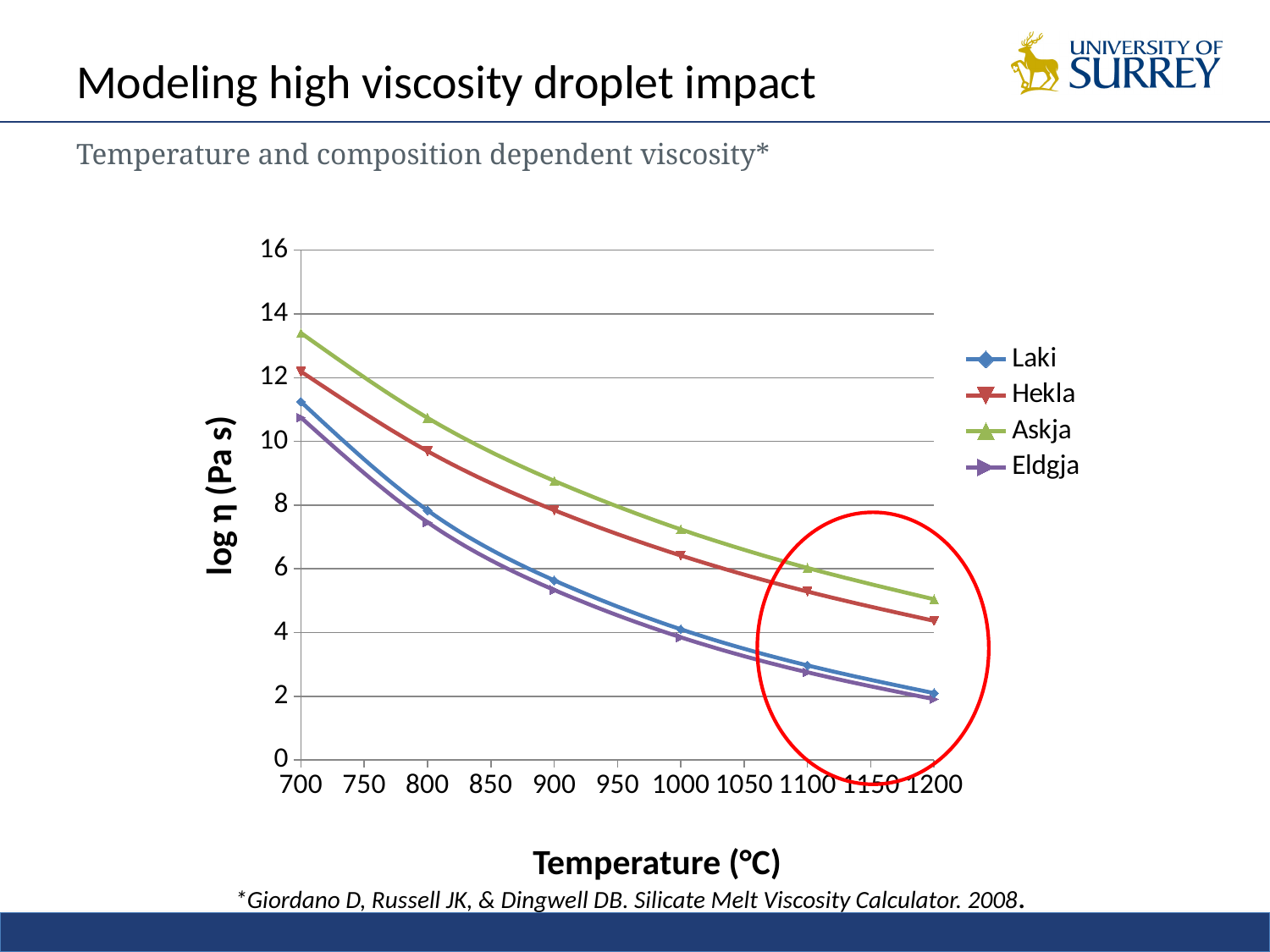
Do the log η values rise or fall as temperature increases along the x axis? fall Is the value for Askja at 700 °C greater or less than 12? greater Is the value for Hekla at 1200 °C greater or less than 4? greater Is the value for Eldgja at 900 °C greater or less than 6? less What kind of chart is shown on the slide? line chart At 1200 °C, which is larger: the value for Hekla or the value for Eldgja? Hekla How many series does the legend list? 4 Which series has the lowest log η value at 700 °C? Eldgja What is the label of the y axis? log η (Pa s) Which series has the highest log η value at 700 °C? Askja How many temperature points are plotted for each series? 6